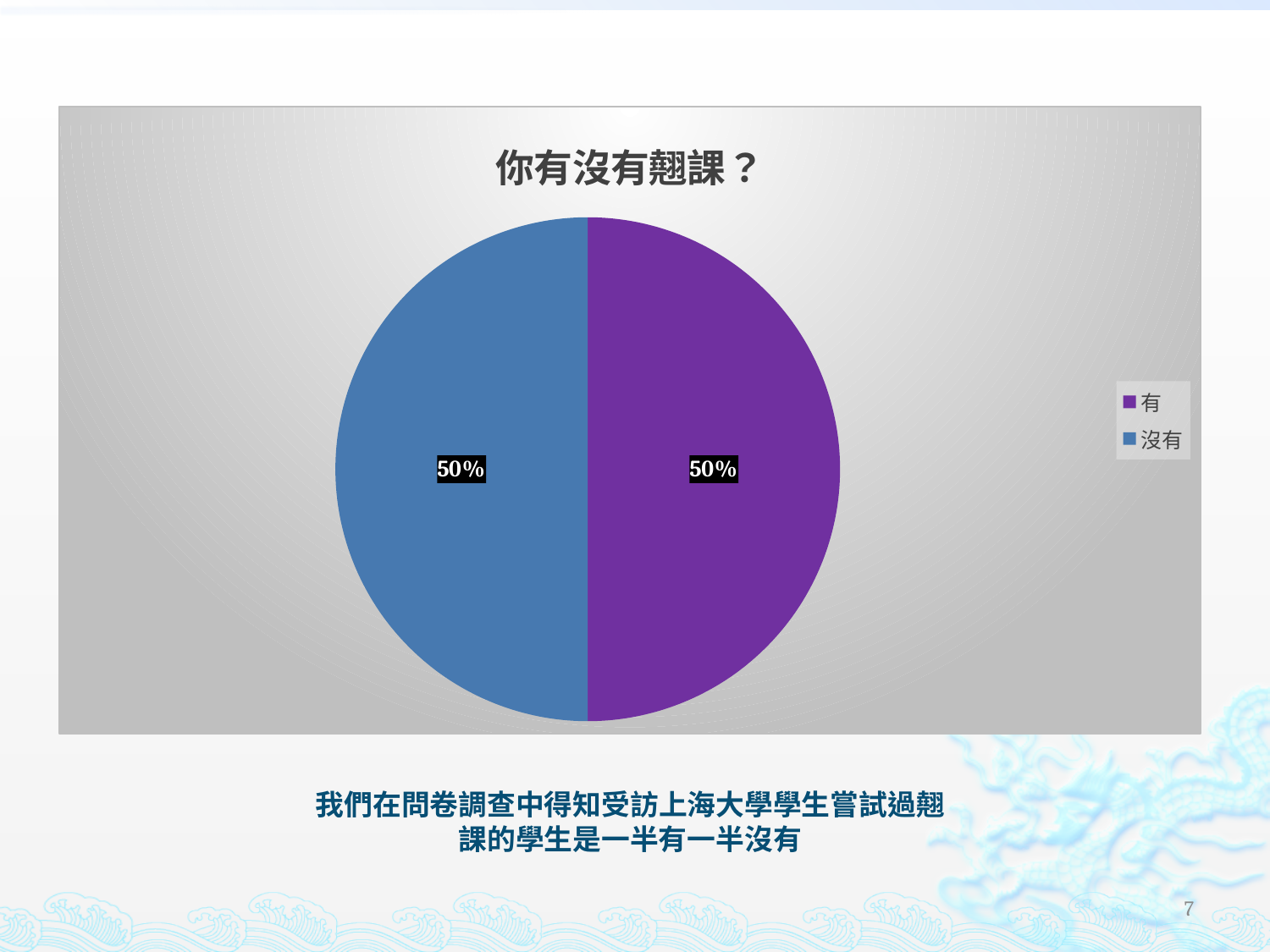
Is the share for 有 larger than, smaller than, or equal to the share for 沒有? equal What is the total of the two slices in the pie chart? 100% What is the title of the chart? 你有沒有翹課？ What percentage of respondents answered 有? 50% How many entries does the legend list? 2 What kind of chart is shown on the slide? pie chart Which colour represents 沒有 in the pie chart? blue What percentage of respondents answered 沒有? 50% What share of the pie does the 有 slice take? 50% How many slices does the pie chart have? 2 What is the difference between the 有 and 沒有 percentages? 0%